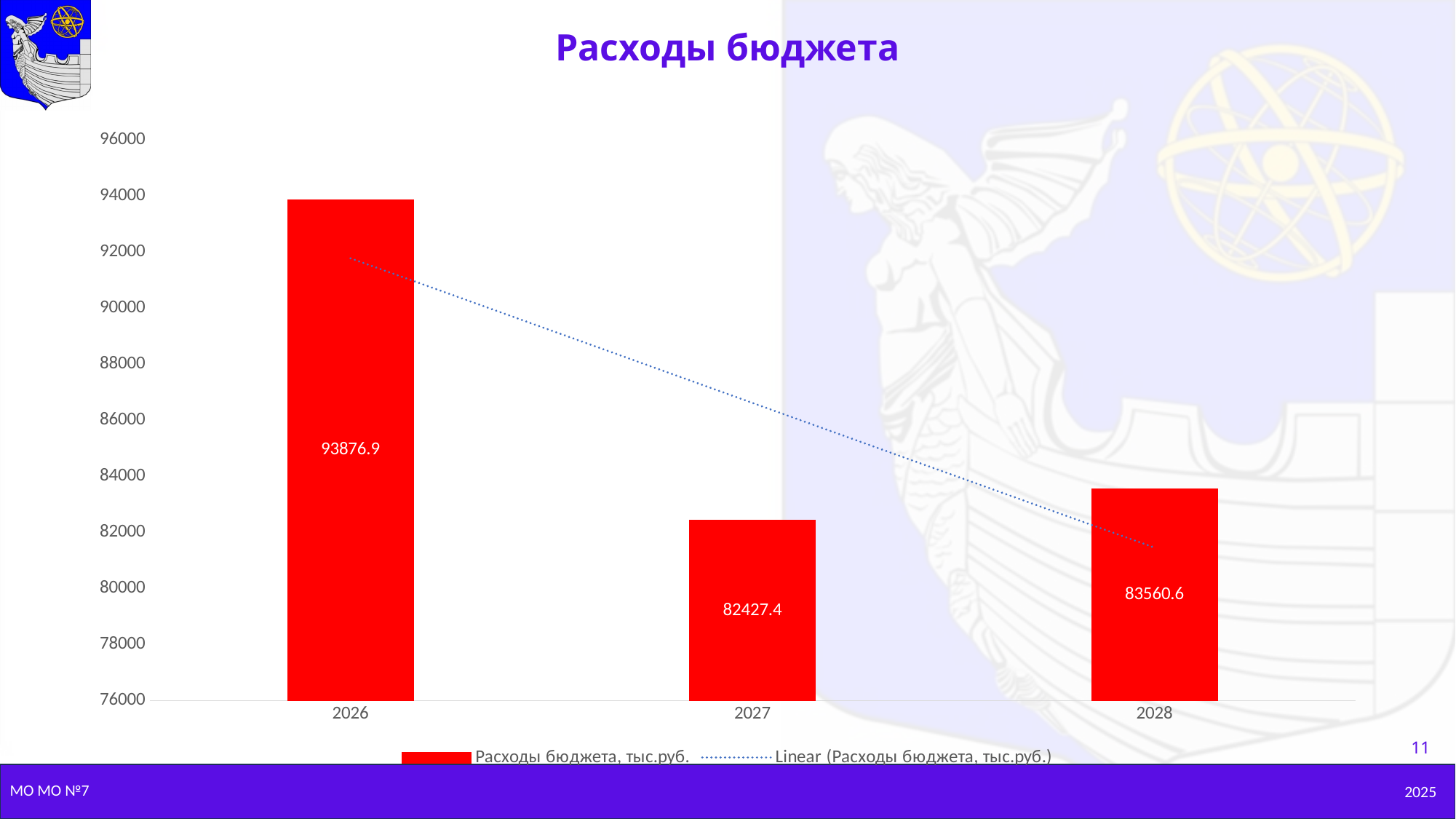
Which year has the highest budget expenditure? 2026 How many years are shown on the x axis of the chart? 3 Does the dotted linear trendline rise or fall from 2026 to 2028? falls What is the difference between the values for 2028 and 2027? 1133.2 What is the value for 2028 in the chart? 83560.6 What is the difference between the values for 2026 and 2027? 11449.5 Which year has the lowest budget expenditure? 2027 Is the value for 2026 greater or less than 90000? greater What is the value for 2027 in the chart? 82427.4 What kind of chart is shown on the slide? bar chart What is the value for 2026 in the chart? 93876.9 Which is larger, the value for 2027 or the value for 2028? 2028